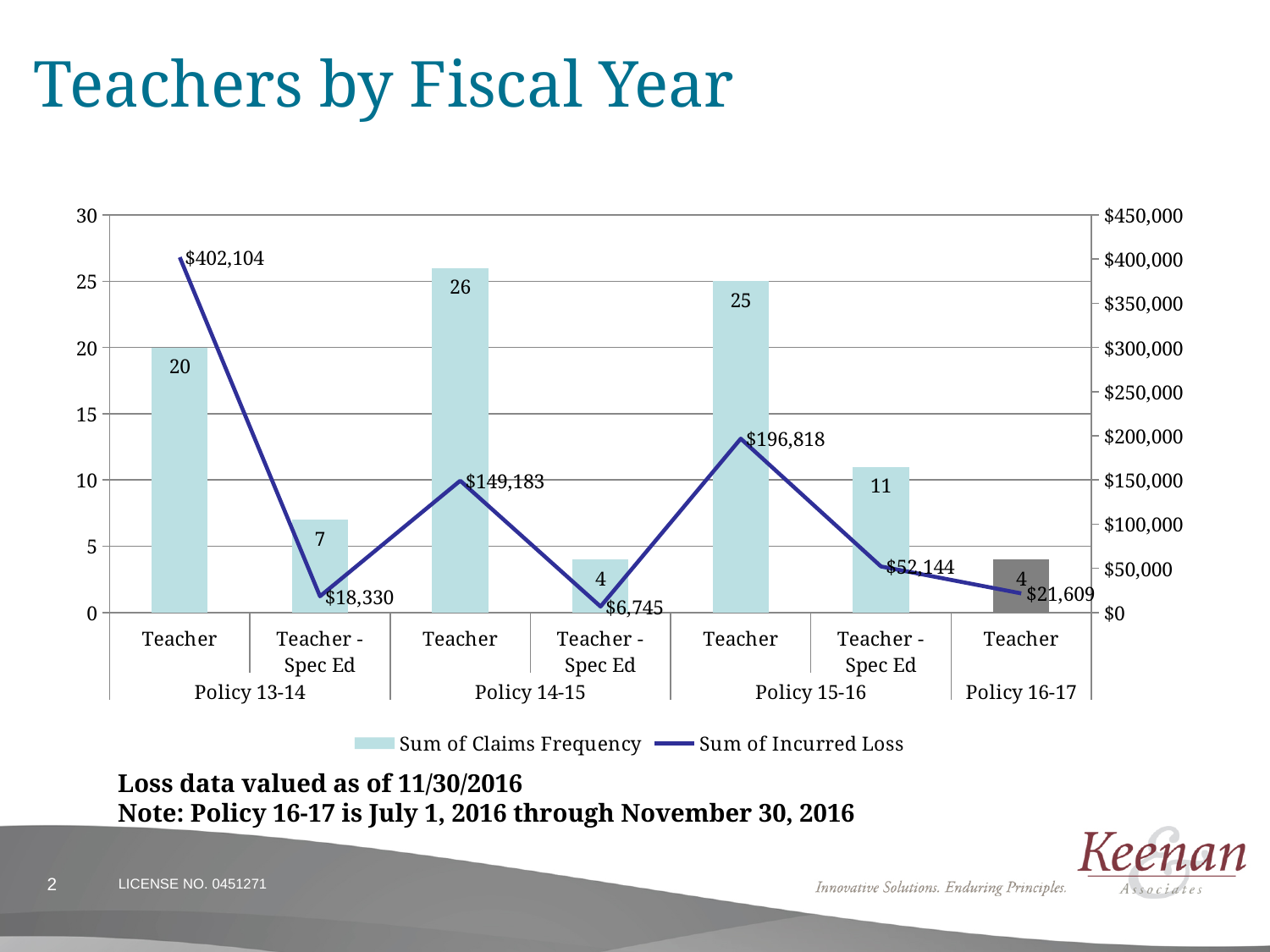
What is the Sum of Incurred Loss for Teacher - Spec Ed in Policy 14-15? $6,745 How many series does the legend list? 2 What is the difference in Sum of Claims Frequency between Teacher in Policy 14-15 and Teacher in Policy 15-16? 1 Which has a larger Sum of Incurred Loss: Teacher in Policy 14-15 or Teacher in Policy 15-16? Teacher in Policy 15-16 How many categories are plotted on the x axis? 7 What is the Sum of Incurred Loss for Teacher in Policy 13-14? $402,104 What is the Sum of Claims Frequency for Teacher in Policy 13-14? 20 What is the Sum of Claims Frequency for Teacher - Spec Ed in Policy 15-16? 11 Which category has the highest Sum of Claims Frequency? Teacher, Policy 14-15 What is the title of the chart? Teachers by Fiscal Year Which category has the lowest Sum of Incurred Loss? Teacher - Spec Ed, Policy 14-15 What is the Sum of Incurred Loss for Teacher in Policy 16-17? $21,609